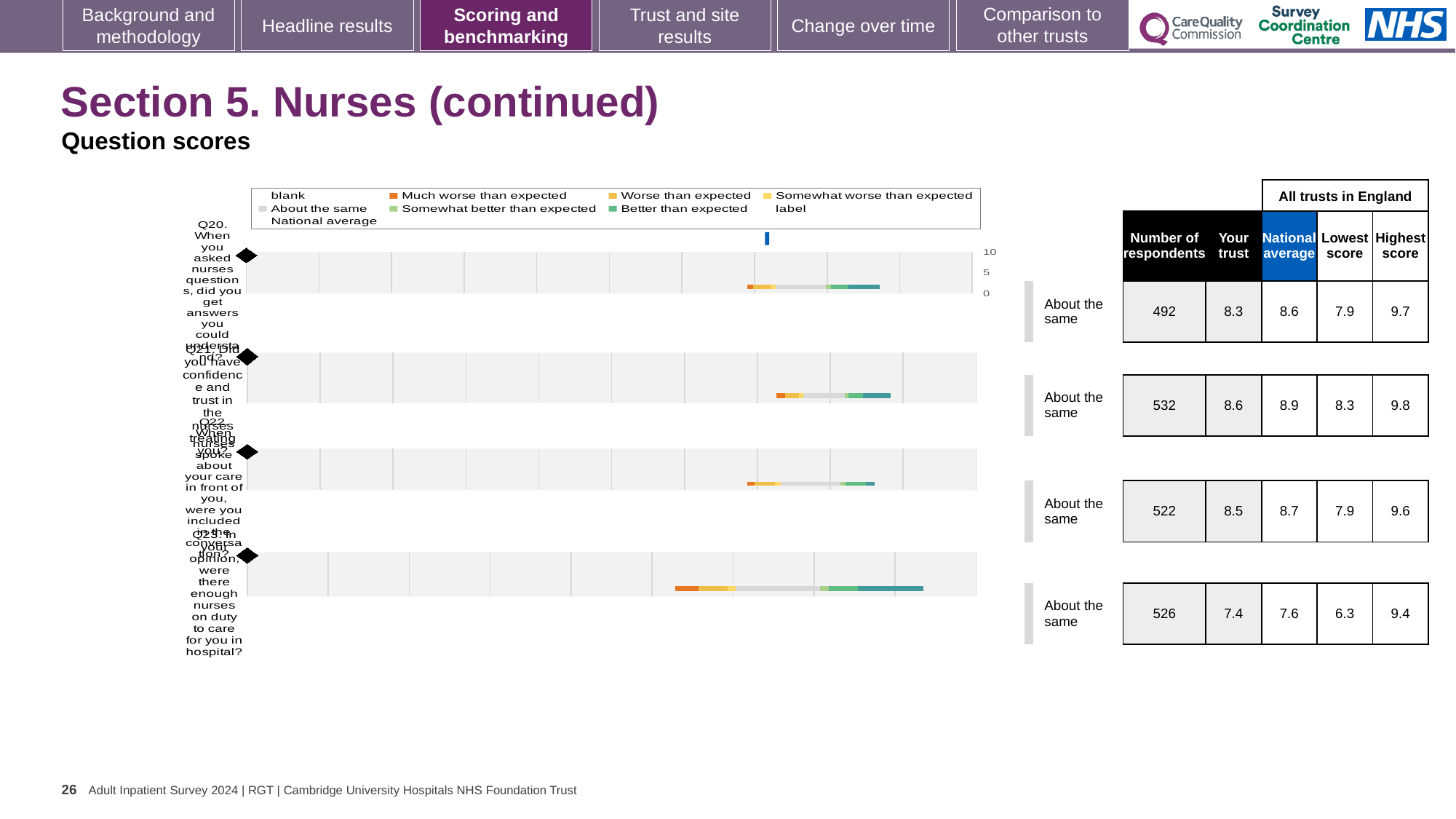
For the Q20 row, which is larger: the 'Your trust' score or the national average? National average How many question rows are charted on the slide? 4 Which question row has the highest national average score? Q21 Is the 'Your trust' score for the Q23 row greater or less than 5 on the chart axis? greater What is the highest score across all trusts in England for the Q21 row? 9.8 In the chart legend, what colour represents 'Much worse than expected'? Orange What benchmark category is shown for the Q22 row (nurses speaking about your care in front of you)? About the same For the Q21 row, what is the difference between the national average and the 'Your trust' score? 0.3 Which question row has the lowest 'Your trust' score? Q23 On the Q20 chart row (when you asked nurses questions, did you get answers you could understand), what is the 'Your trust' score shown? 8.3 What kind of chart is used for each question row? Bar chart For the Q23 row (were there enough nurses on duty), how many respondents are shown? 526